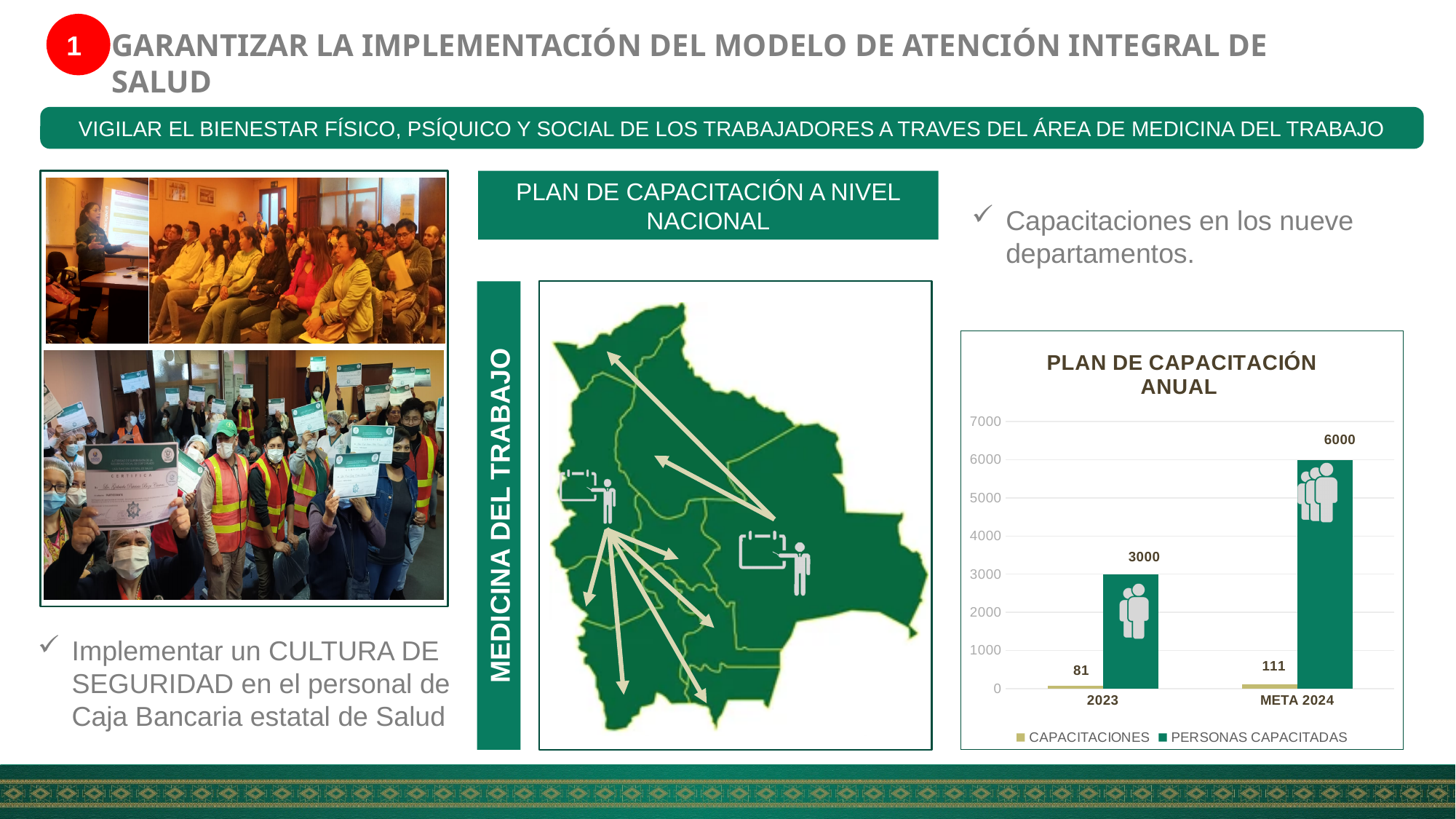
What is the difference between PERSONAS CAPACITADAS in META 2024 and in 2023? 3000 What is the value for CAPACITACIONES in 2023? 81 How many series does the chart legend list? 2 What is the value for PERSONAS CAPACITADAS in META 2024? 6000 What is the value for CAPACITACIONES in META 2024? 111 How many categories are shown on the x axis of the chart? 2 Which category has the higher value for PERSONAS CAPACITADAS, 2023 or META 2024? META 2024 Is the value for PERSONAS CAPACITADAS in META 2024 greater or less than 5000? greater What is the value for PERSONAS CAPACITADAS in 2023? 3000 What kind of chart is shown on the slide? bar chart What is the difference between CAPACITACIONES in META 2024 and in 2023? 30 What is the title of the chart? PLAN DE CAPACITACIÓN ANUAL